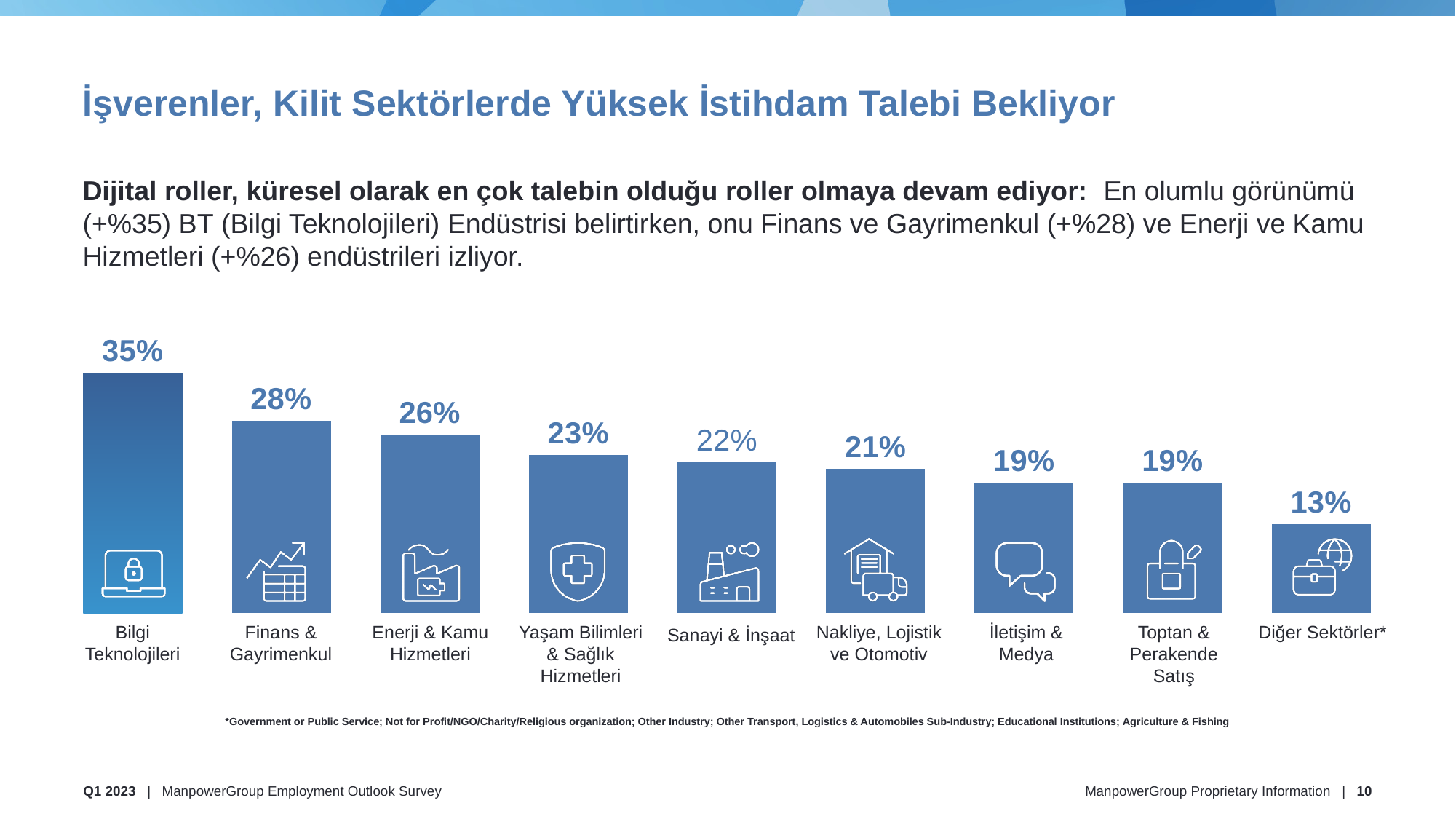
Which two categories share the value 19%? İletişim & Medya and Toptan & Perakende Satış How many categories are shown in the chart? 9 What is the value for Sanayi & İnşaat? 22% Which category has the highest value? Bilgi Teknolojileri What is the value for Nakliye, Lojistik ve Otomotiv? 21% Which category has the lowest value? Diğer Sektörler* Do the values rise or fall from left to right across the chart? Fall What is the difference between the values for Bilgi Teknolojileri and Finans & Gayrimenkul? 7% What is the difference between the values for Enerji & Kamu Hizmetleri and Diğer Sektörler*? 13% What kind of chart is shown on the slide? Bar chart What is the value for Bilgi Teknolojileri? 35% Which is larger, the value for Yaşam Bilimleri & Sağlık Hizmetleri or the value for İletişim & Medya? Yaşam Bilimleri & Sağlık Hizmetleri